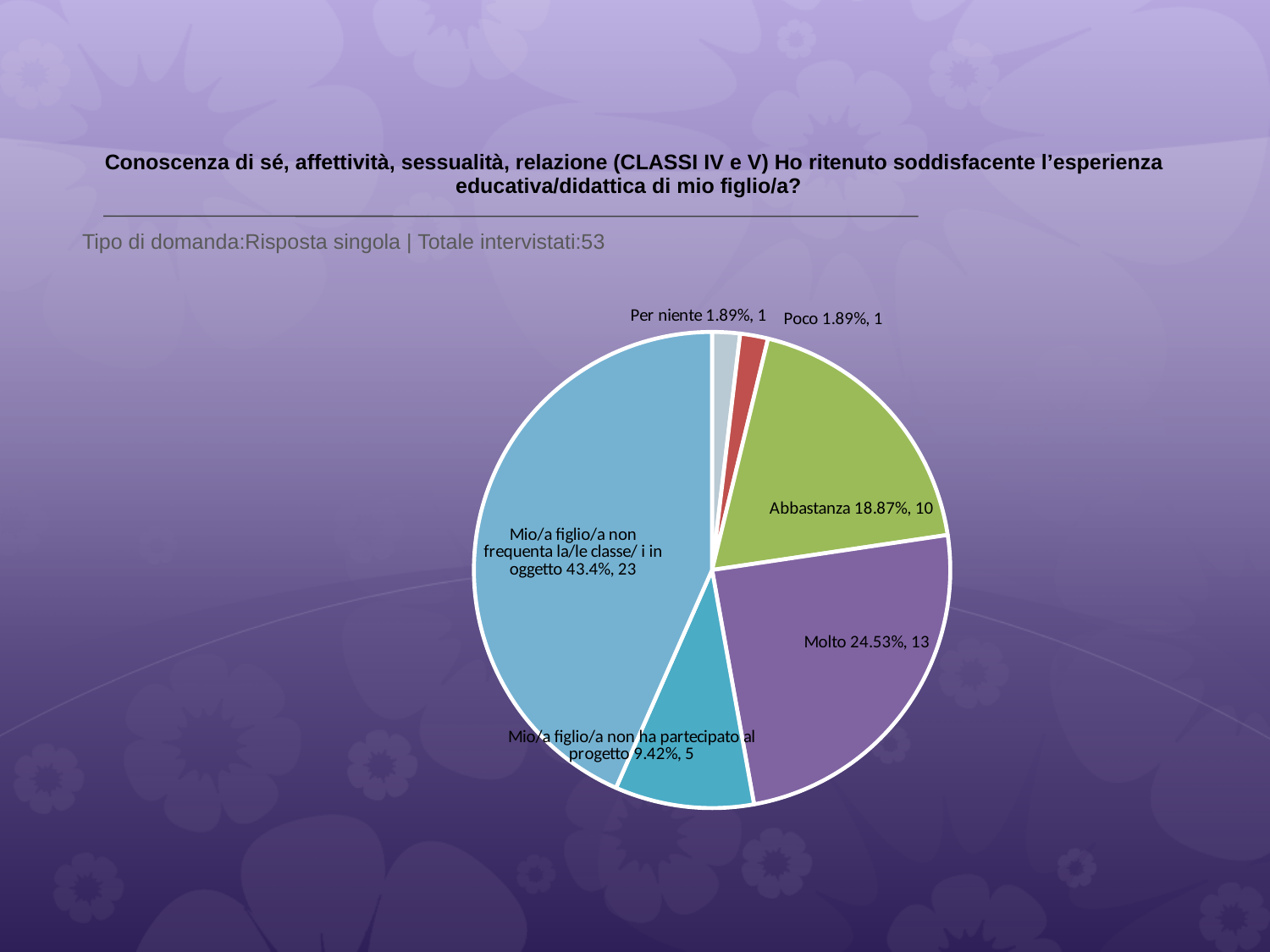
What share of the pie does the "Poco" slice represent? 1.89% How many respondents answered "Per niente"? 1 How many respondents answered "Abbastanza"? 10 Which is larger, the "Molto" slice or the "Abbastanza" slice? Molto Which category has the largest slice of the pie? Mio/a figlio/a non frequenta la/le classe/i in oggetto What is the difference in respondent count between "Mio/a figlio/a non frequenta la/le classe/i in oggetto" and "Molto"? 10 What is the difference in respondent count between "Molto" and "Abbastanza"? 3 What is the total number of respondents (Totale intervistati) stated on the slide? 53 What percentage is shown for "Mio/a figlio/a non ha partecipato al progetto"? 9.42% How many slices does the pie chart have? 6 What kind of chart is shown on the slide? pie chart What percentage is shown for the "Molto" slice? 24.53%